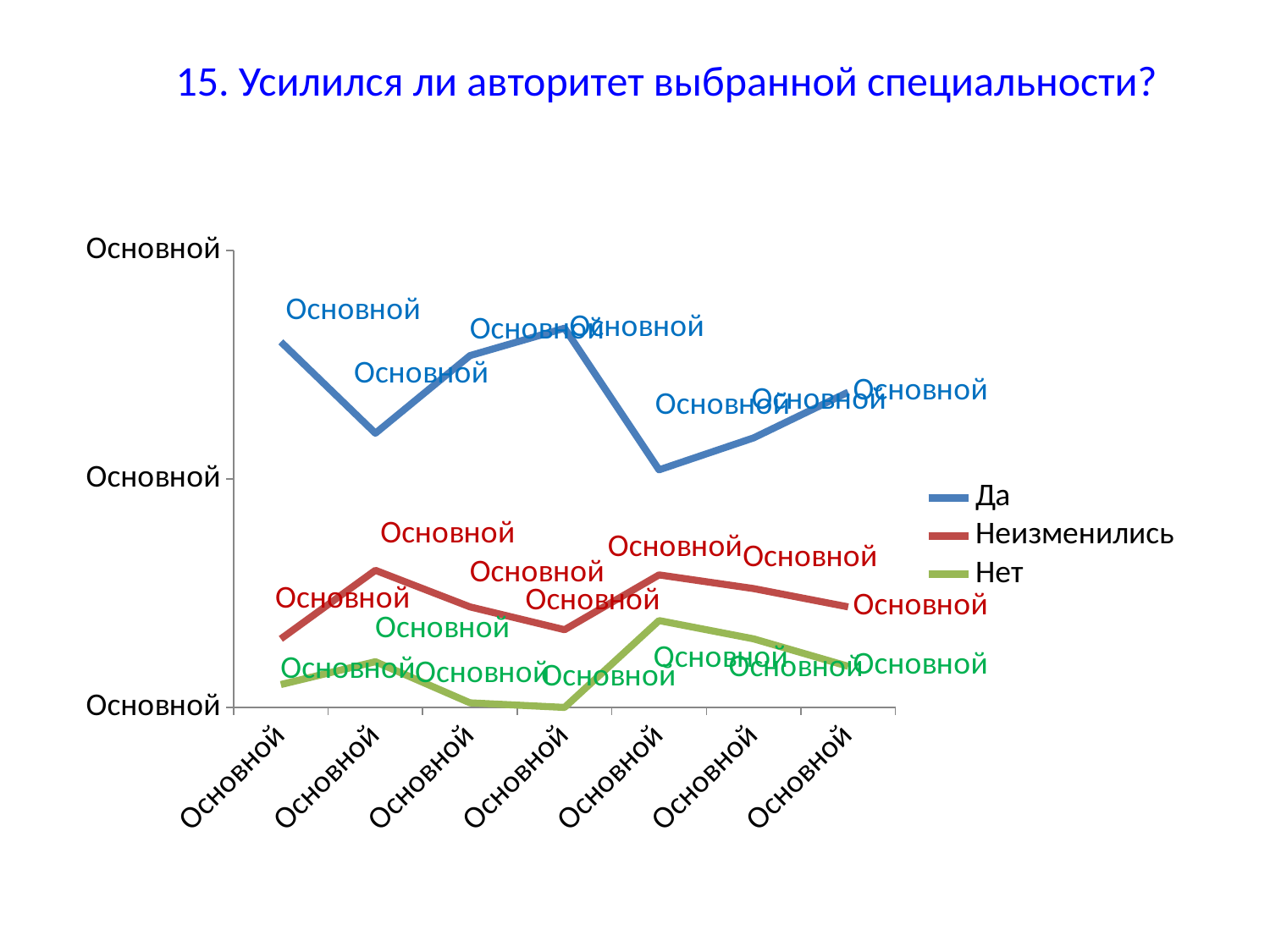
Which series is plotted higher, Неизменились or Нет? Неизменились Which series has the highest values across the chart? Да How many points are plotted along the x axis for each series? 7 What are the series names listed in the legend? Да, Неизменились, Нет Which series is plotted higher, Да or Неизменились? Да What kind of chart is shown on the slide? line chart What is the title of the slide? 15. Усилился ли авторитет выбранной специальности? What colour is the line for the series Да? blue Which series has the lowest values across the chart? Нет How many series does the legend list? 3